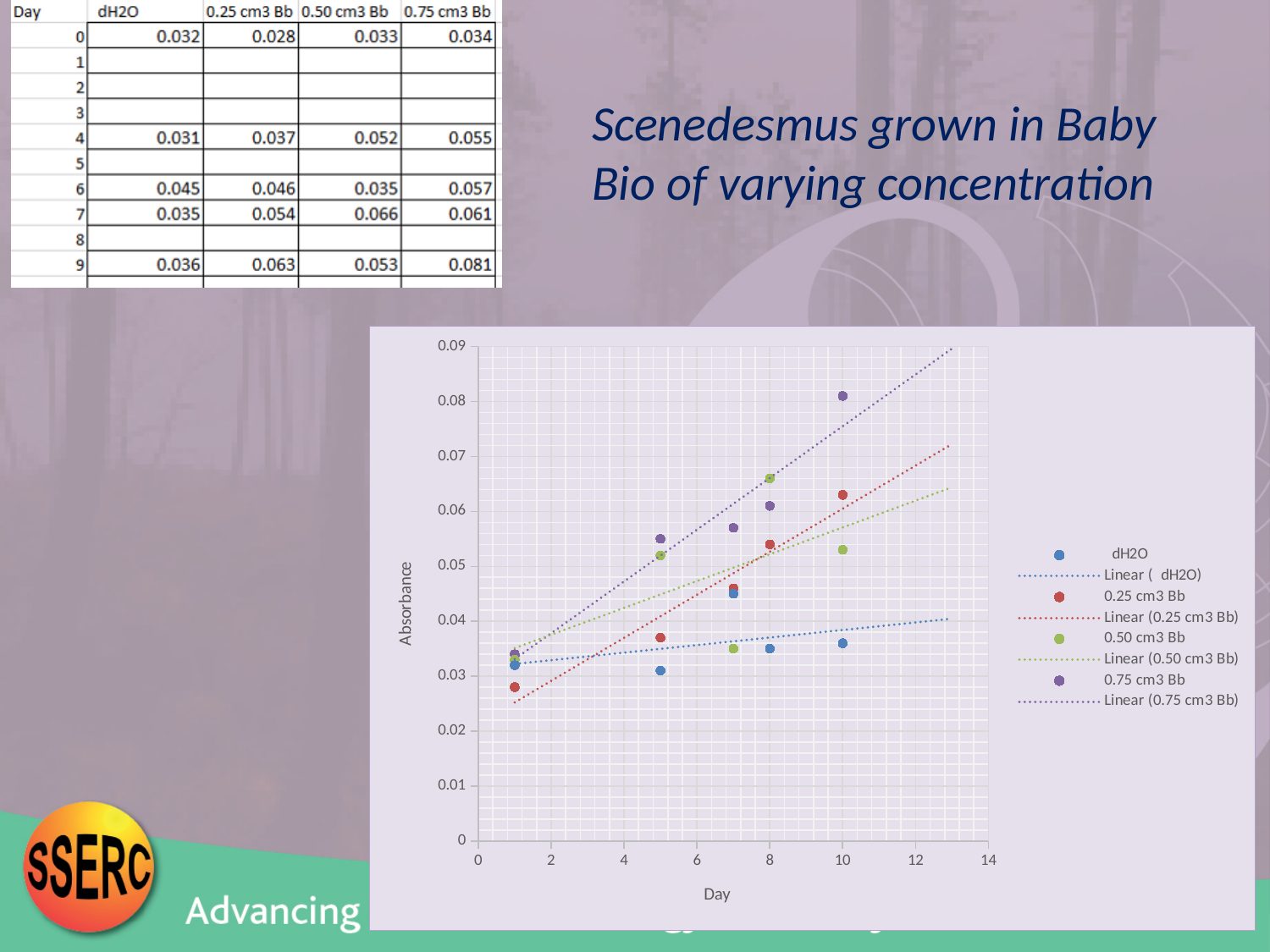
According to the table on the slide, what is the difference between the day 9 absorbance for 0.75 cm3 Bb and for dH2O? 0.045 What is the label of the horizontal axis of the chart? Day What is the label of the vertical axis of the chart? Absorbance According to the table on the slide, what is the absorbance for dH2O on day 0? 0.032 Is the dH2O point plotted at x = 5 greater or less than 0.04? less Which series has the highest plotted absorbance value on the chart? 0.75 cm3 Bb What kind of chart is shown on the slide? Scatter chart with linear trendlines Is the highest plotted value for the 0.75 cm3 Bb series greater or less than 0.07? greater How many entries does the chart legend list? 8 How many data series (excluding the linear trendlines) does the chart legend list? 4 According to the table on the slide, what is the absorbance for 0.75 cm3 Bb on day 9? 0.081 Does the linear trendline for 0.75 cm3 Bb rise or fall as Day increases? rise